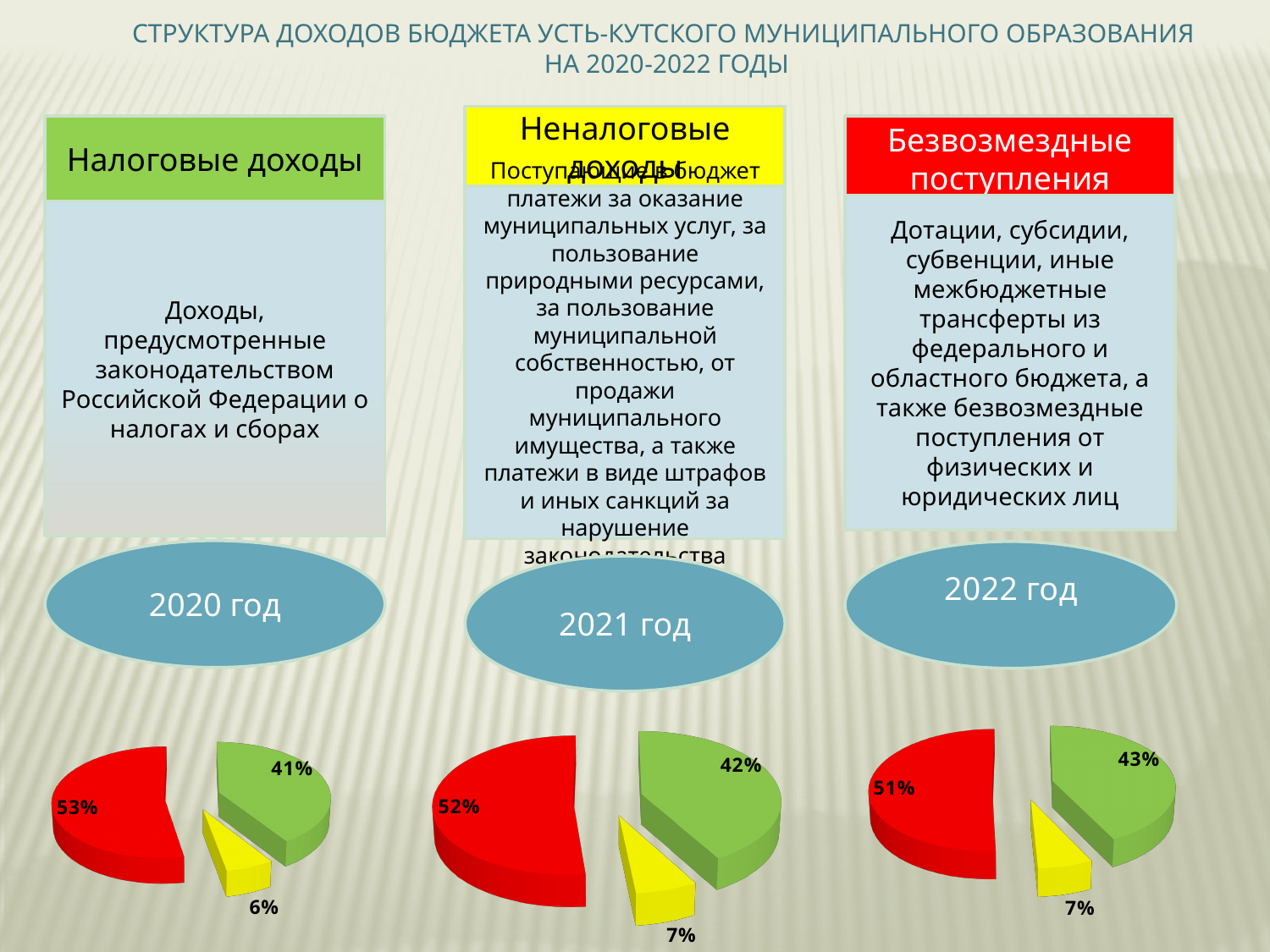
Across the 2020, 2021 and 2022 pie charts, does the red slice (безвозмездные поступления) rise or fall over the years? fall How many pie charts are shown on the slide? 3 In the 2022 год pie chart, which slice is the largest? 51% (red, безвозмездные поступления) In the 2020 год pie chart, what share is shown for the red slice (безвозмездные поступления)? 53% In the 2020 год pie chart, which slice is the smallest? 6% (yellow, неналоговые доходы) In the 2021 год pie chart, what share is shown for the green slice (налоговые доходы)? 42% In the 2021 год pie chart, what is the difference between the red slice (52%) and the green slice (42%)? 10% In the 2022 год pie chart, what share is shown for the yellow slice (неналоговые доходы)? 7% Across the 2020, 2021 and 2022 pie charts, does the green slice (налоговые доходы) rise or fall over the years? rise How many slices does the 2022 год pie chart have? 3 In the 2020 год pie chart, which is larger: the green slice or the red slice? the red slice (53%) What type of chart is used to show the budget structure for each year? pie chart